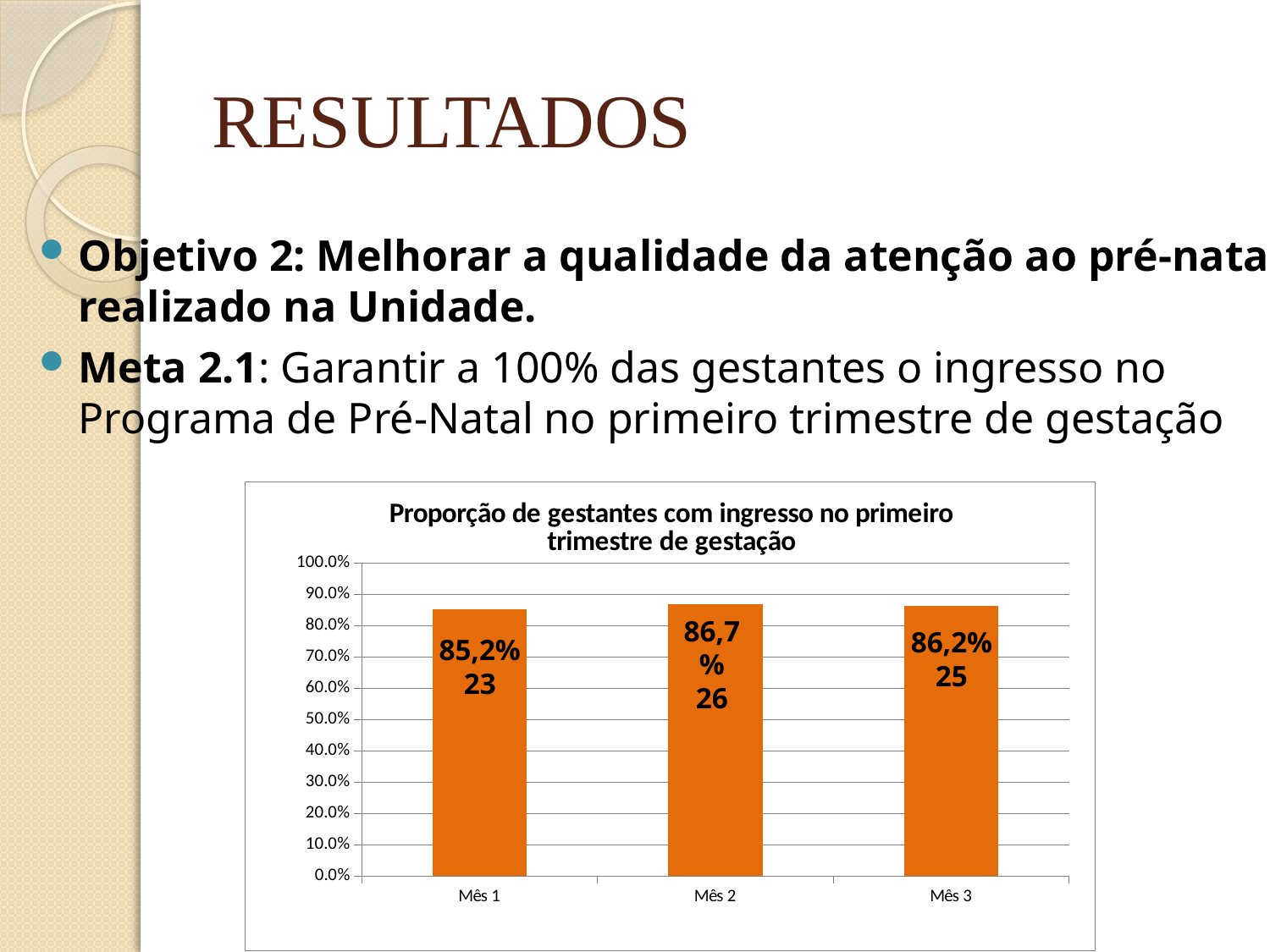
What count is printed on the bar for Mês 2? 26 Which month has the lowest proportion? Mês 1 What percentage is shown for Mês 3? 86,2% Is the value for Mês 2 greater or less than 90.0%? less What percentage is shown for Mês 2? 86,7% What kind of chart is shown? bar chart Which is larger, the percentage for Mês 3 or for Mês 1? Mês 3 What is the difference between the counts printed for Mês 3 and Mês 1? 2 What percentage is shown for Mês 1? 85,2% What is the difference between the percentages for Mês 2 and Mês 1? 1,5% Which month has the highest proportion? Mês 2 How many months are shown on the x axis? 3